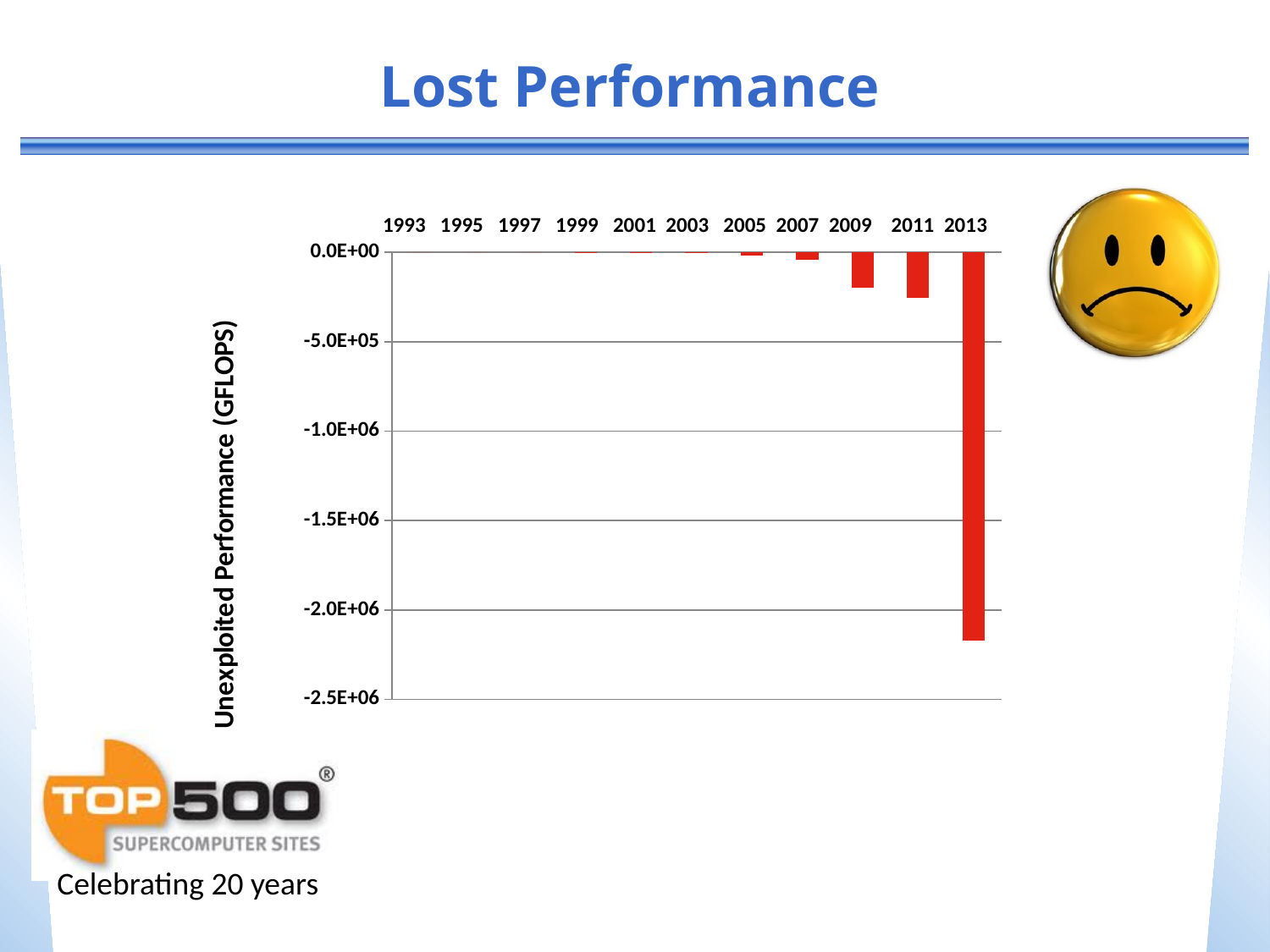
Which year has the lowest (most negative) value in the chart? 2013 How many year labels are shown on the x axis? 11 What is the label on the vertical axis of the chart? Unexploited Performance (GFLOPS) Is the value for 2011 greater or less than -5.0E+05? greater What kind of chart is shown on the slide? bar chart What is the lowest tick value shown on the vertical axis? -2.5E+06 Is the value for 2013 greater or less than -2.0E+06? less Which year has the lower value, 2011 or 2013? 2013 Which year has the lower value, 2005 or 2013? 2013 What is the title of the slide containing the chart? Lost Performance Do the values rise or fall as the years progress from 1993 to 2013? fall Is the value for 2009 greater or less than -5.0E+05? greater